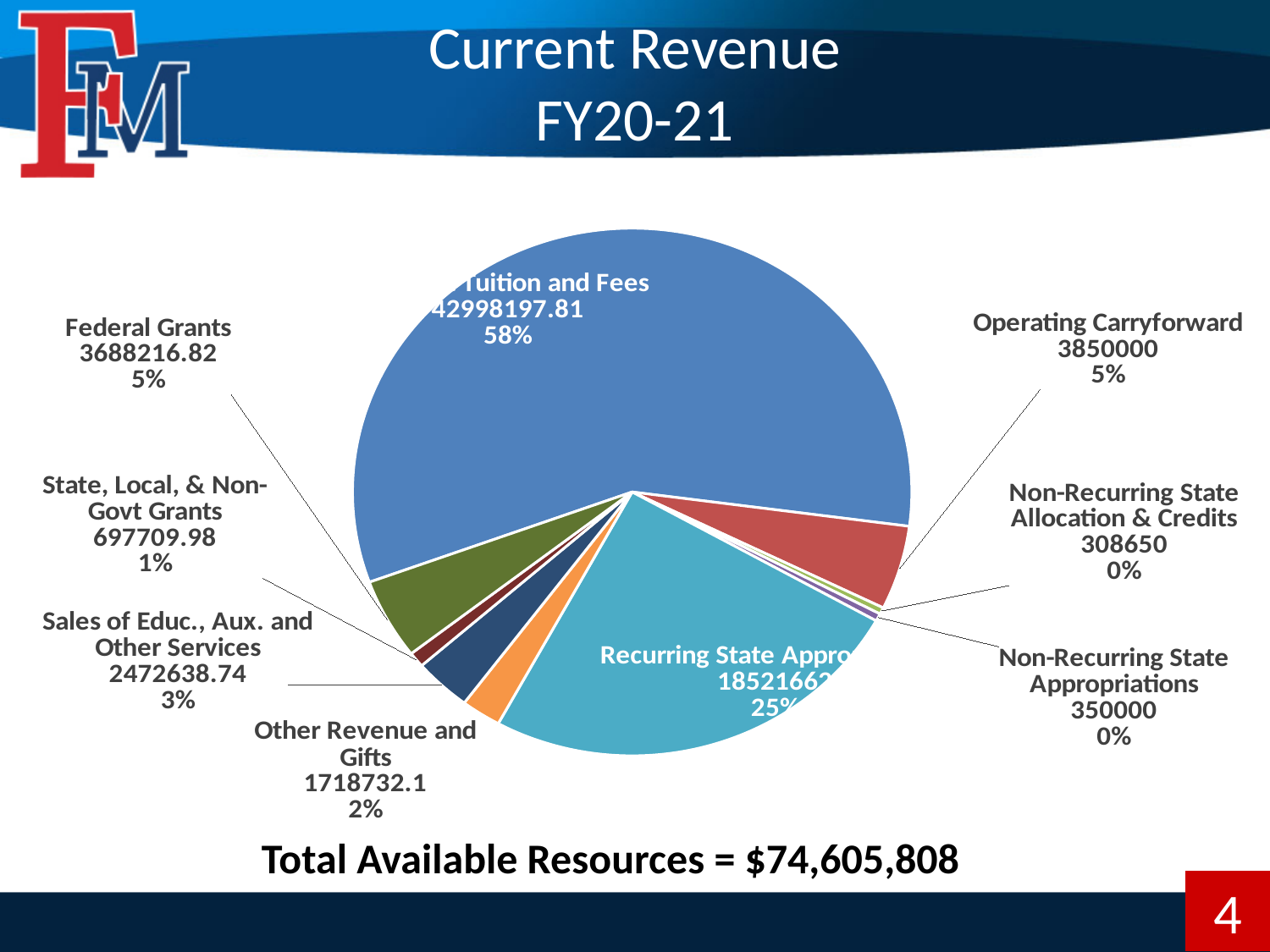
What is the value shown for Non-Recurring State Allocation & Credits? 308650 Which category has the largest slice of the pie? Tuition and Fees What is the difference between Operating Carryforward and Federal Grants? 161783.18 What percentage of the pie is Recurring State Appropriations? 25% Which is larger, Federal Grants or Sales of Educ., Aux. and Other Services? Federal Grants What share of the pie does Tuition and Fees represent? 58% What kind of chart is shown on the slide? pie chart How many slices does the pie chart have? 9 What total available resources figure is stated below the chart? $74,605,808 What is the value shown for Federal Grants? 3688216.82 What is the value shown for Operating Carryforward? 3850000 What is the value shown for Other Revenue and Gifts? 1718732.1